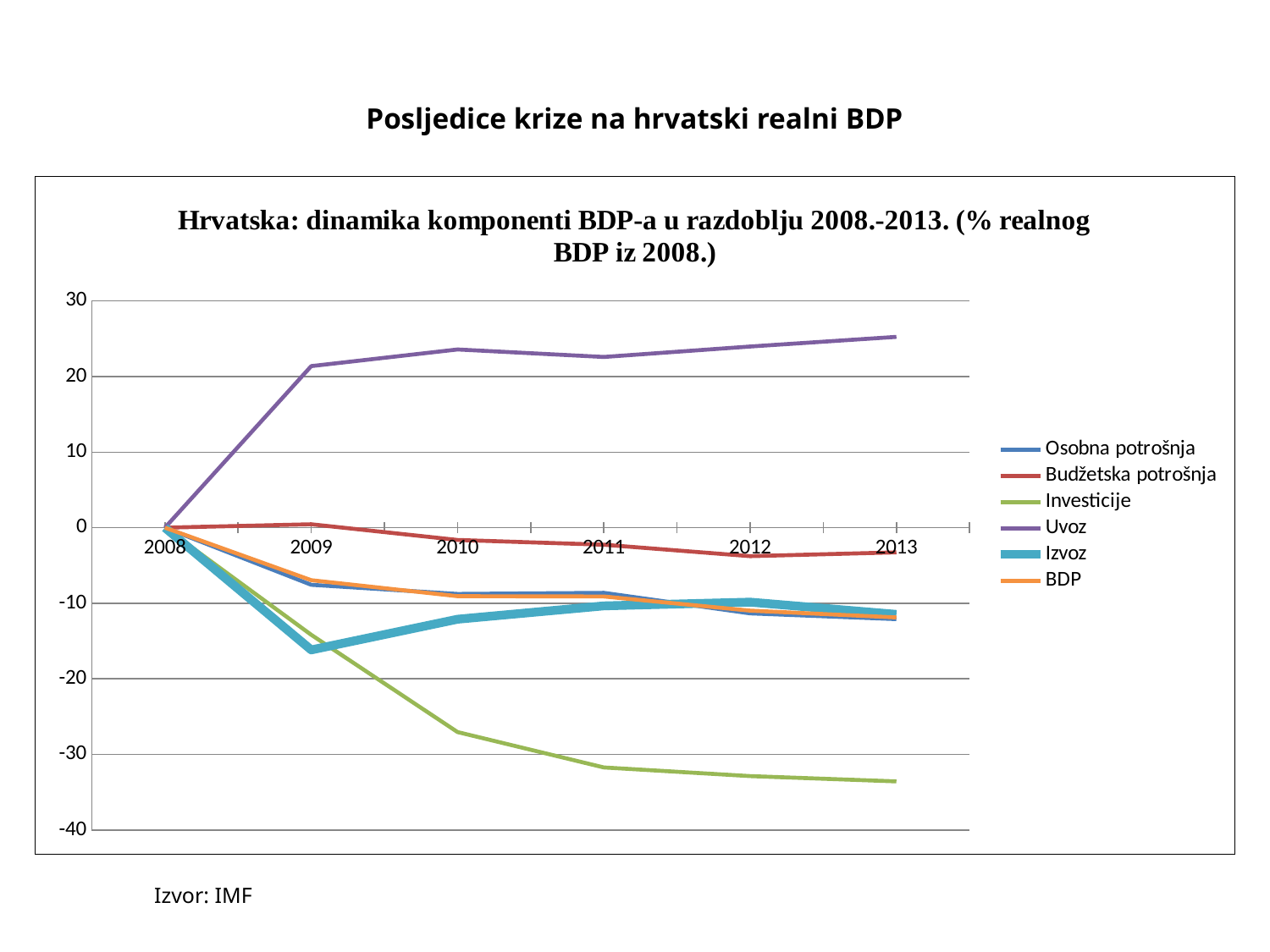
Do the values for Investicije rise or fall from 2008 to 2013? fall What kind of chart is shown on the slide? line chart Is the value for Investicije in 2013 greater or less than -30? less Is the value for Uvoz in 2013 greater or less than 20? greater Which series has the lowest value in 2013? Investicije Which series has the highest value in 2013? Uvoz Is the value for Izvoz in 2009 greater or less than -10? less What is the value for Uvoz in 2008? 0 How many series does the legend list? 6 What source is cited below the chart? IMF Which is larger in 2012, Budžetska potrošnja or Investicije? Budžetska potrošnja How many years are shown on the x axis? 6